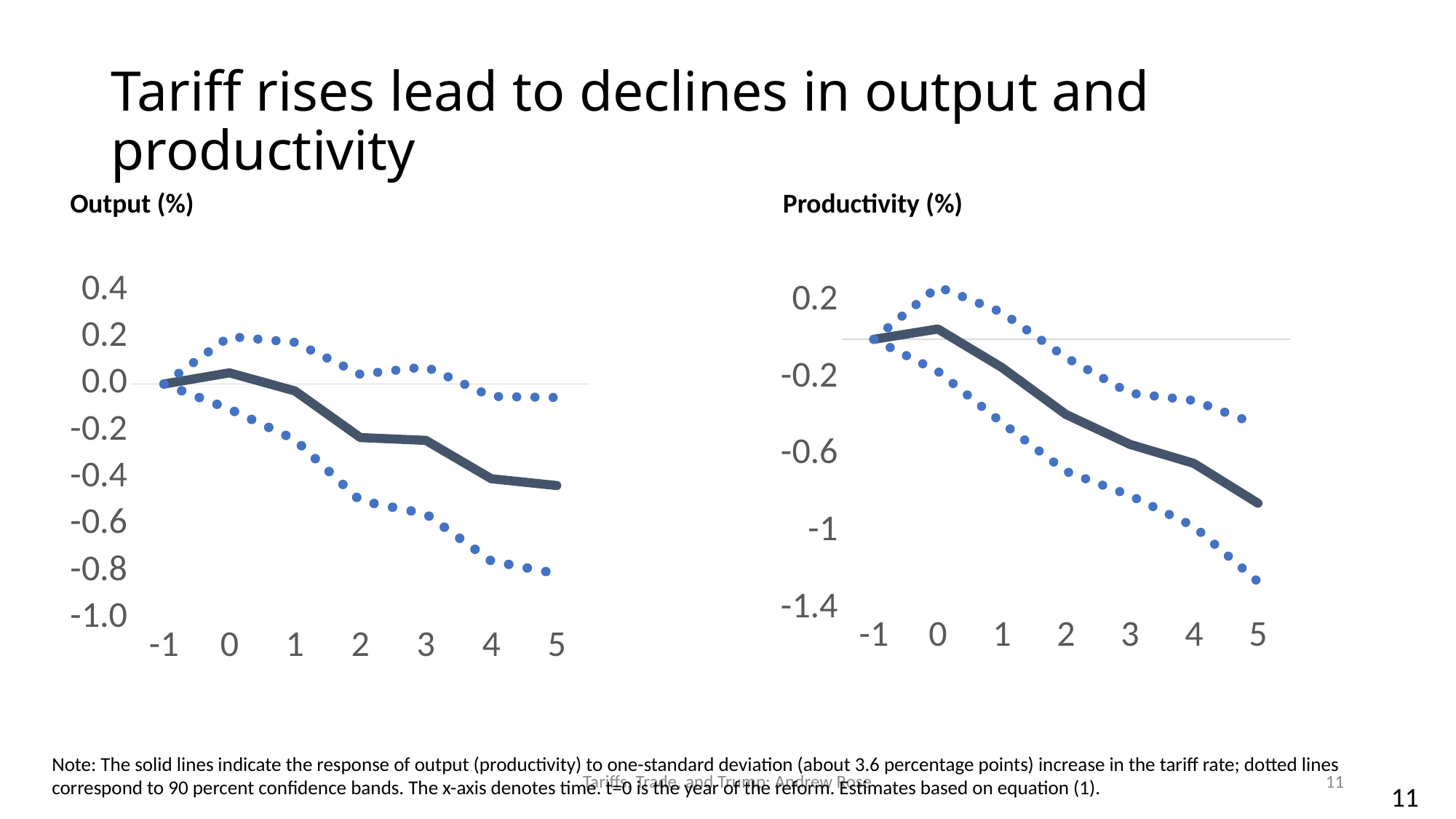
In the Productivity (%) chart, does the solid line generally rise or fall from time 0 to time 5? fall In the Output (%) chart, at which time point is the solid line highest? 0 How many time points are shown on the x axis of the Productivity (%) chart? 7 In the Output (%) chart, at which time point is the solid line lowest? 5 What kind of chart is the Output (%) chart? line chart In the Output (%) chart, is the solid line higher at time 1 or at time 4? time 1 In the Output (%) chart, does the solid line generally rise or fall from time 0 to time 5? fall At time 5, which chart's solid line is lower, Output (%) or Productivity (%)? Productivity (%) In the Productivity (%) chart, is the solid line value at time 5 greater or less than -0.6? less In the Output (%) chart, is the lower dotted band at time 5 greater or less than -0.6? less In the Productivity (%) chart, at which time point is the solid line lowest? 5 In the Output (%) chart, is the solid line value at time 2 greater or less than 0.0? less